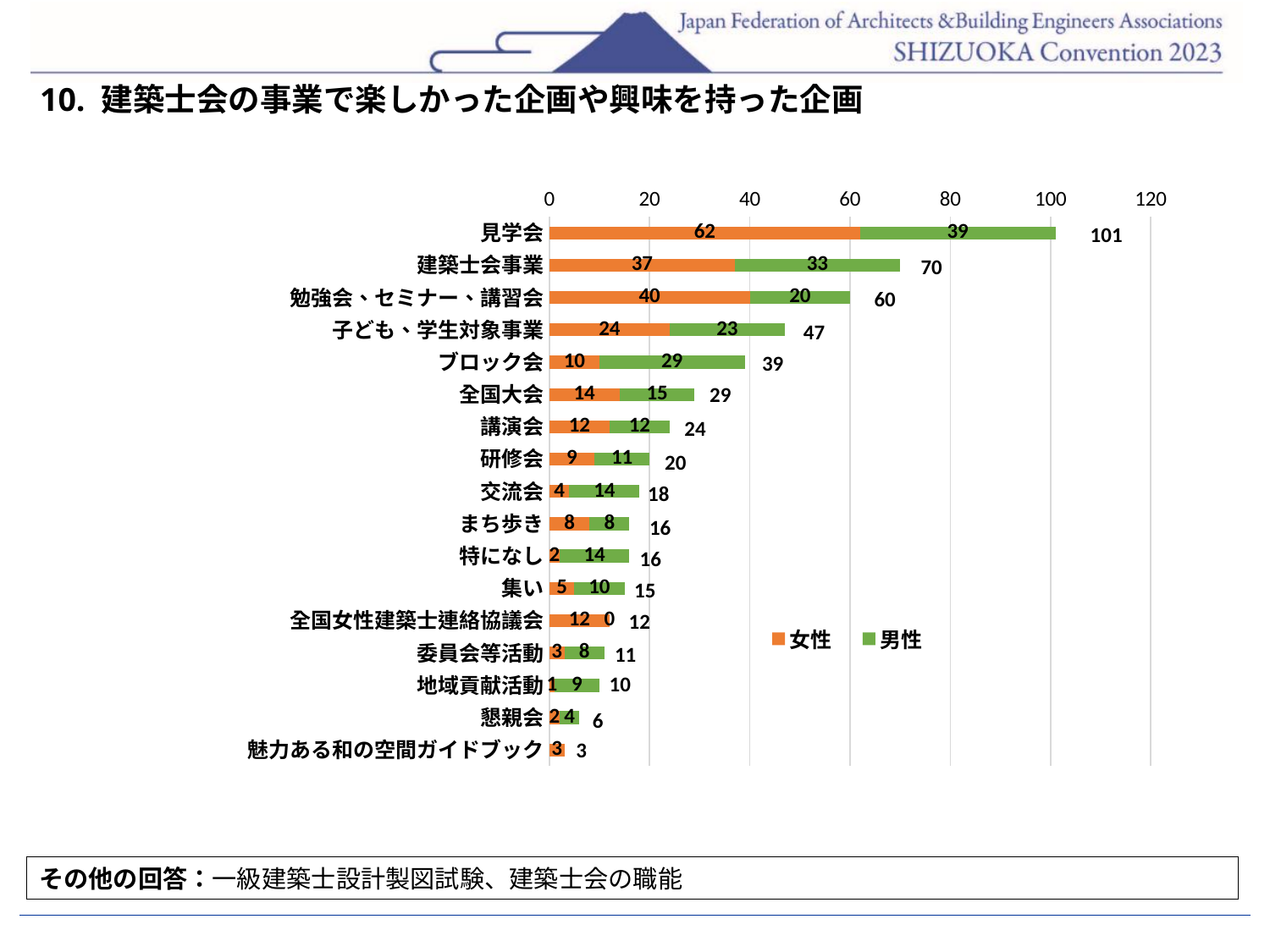
What is the total for 建築士会事業? 70 How many categories are shown on the chart? 17 What is the 男性 value for ブロック会? 29 What is the 男性 value for 全国女性建築士連絡協議会? 0 Which category has the highest total? 見学会 What is the 女性 value for 見学会? 62 What is the difference between the 女性 and 男性 values for 勉強会、セミナー、講習会? 20 What kind of chart is shown on the slide? Stacked bar chart Which colour represents 女性 in the chart? Orange How many series does the legend list? 2 Which is larger for 交流会, the 女性 value or the 男性 value? 男性 Which category has the lowest total? 魅力ある和の空間ガイドブック